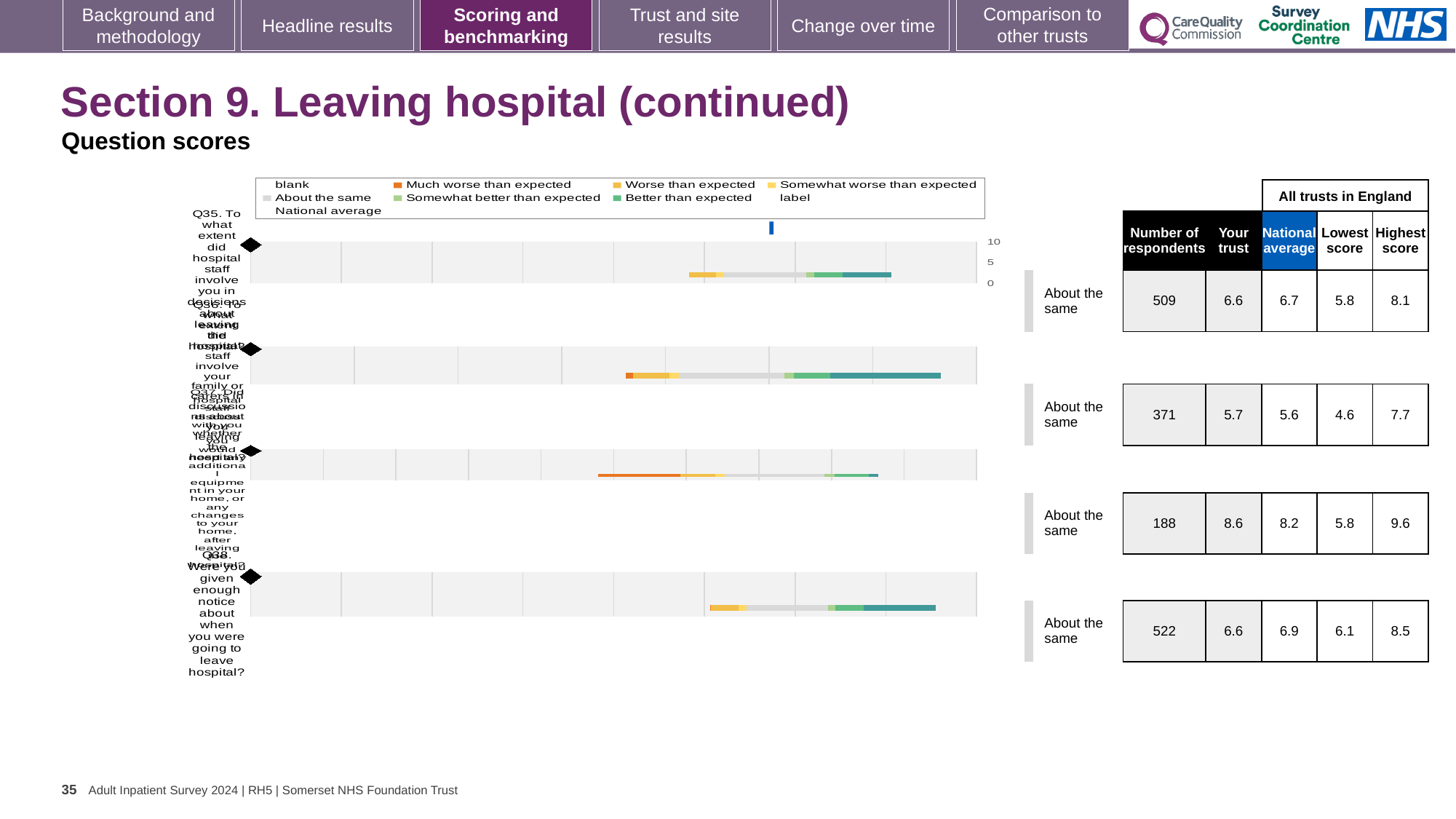
In the table beside the chart, which row has the lowest number of respondents? Q37 (188) In the table beside the chart, what is the national average for the last row (Q38)? 6.9 Which legend entry is shown in dark teal? Better than expected In the table beside the chart, what is the 'Your trust' score for the third row (Q37)? 8.6 How many question rows (Q35 to Q38) are plotted in the chart area? 4 In the table beside the chart, is the 'Your trust' score for the first row (Q35) larger or smaller than its national average? smaller In the table beside the chart, what is the difference between the highest score and lowest score for the second row (Q36)? 3.1 What benchmark category is shown next to every question row on this slide? About the same In the table beside the chart, which row has the highest 'Your trust' score? Q37 (8.6) In the table beside the chart, what is the number of respondents for the first row (Q35)? 509 What kind of chart is used to show the question scores on this slide? bar chart Which legend entry is shown in dark orange? Much worse than expected